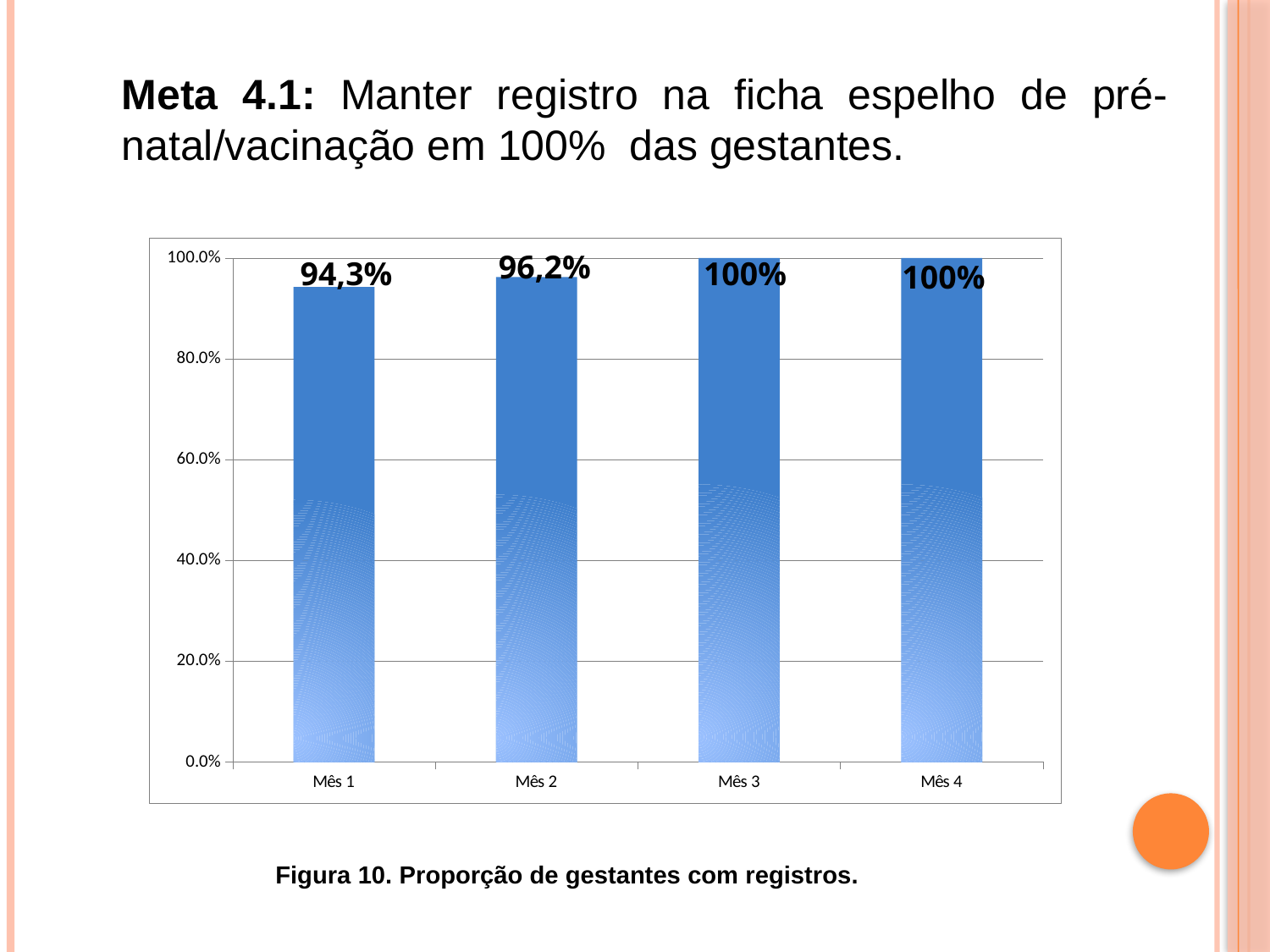
What is the difference between the values for Mês 3 and Mês 1? 5,7 percentage points What is the value for Mês 2? 96,2% Do the values rise or fall from Mês 1 to Mês 3? Rise Which is larger, the value for Mês 1 or the value for Mês 2? Mês 2 What is the value for Mês 3? 100% Which months share the highest value? Mês 3 and Mês 4 What is the value for Mês 4? 100% How many months are shown on the x axis? 4 Which month has the lowest value? Mês 1 What is the value for Mês 1? 94,3% What kind of chart is shown on the slide? Bar chart What is the difference between the values for Mês 2 and Mês 1? 1,9 percentage points